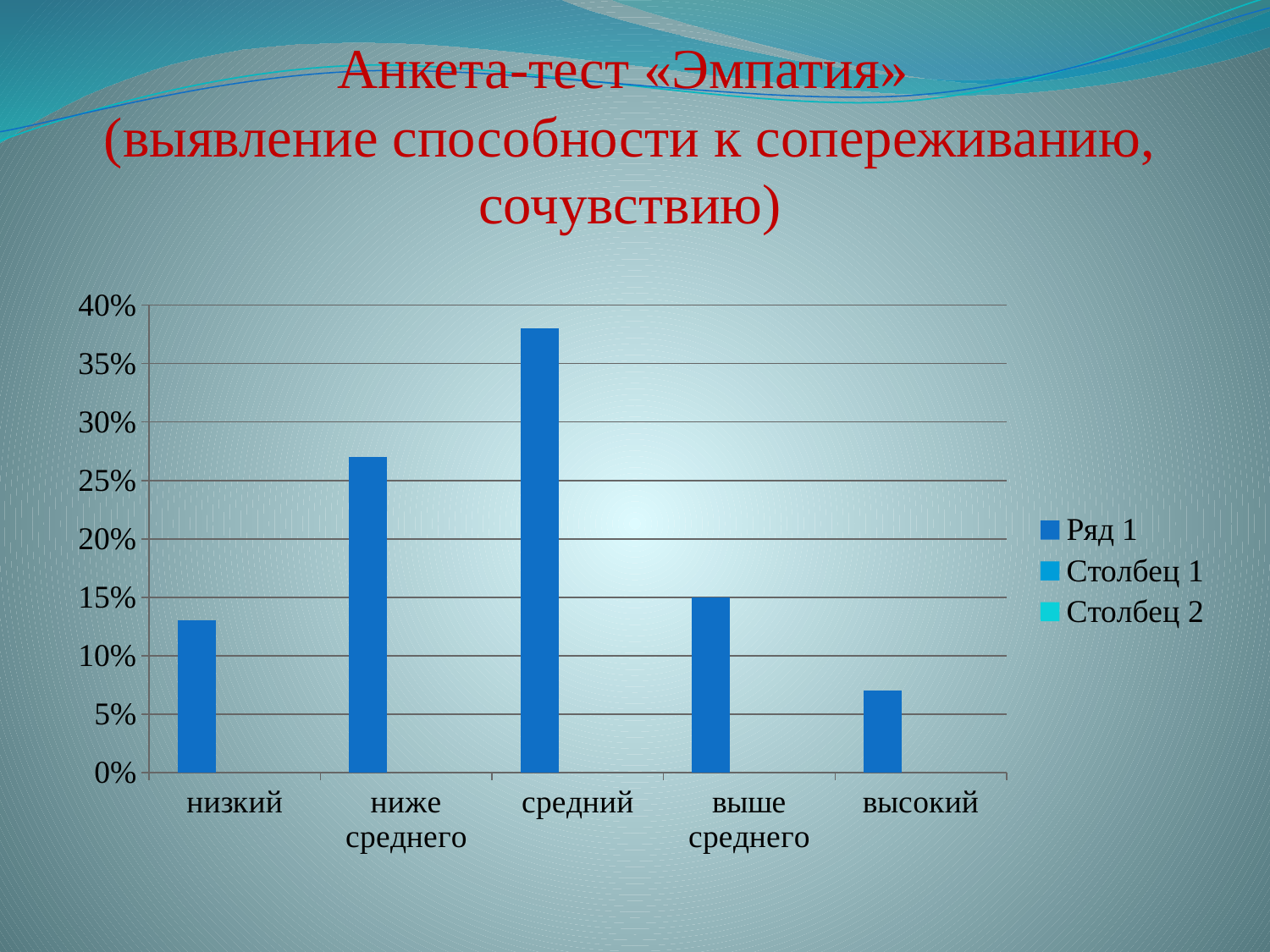
Is the value for "ниже среднего" greater or less than 25%? greater What kind of chart is shown on the slide? bar chart Is the value for "низкий" greater or less than 10%? greater Is the value for "средний" greater or less than 35%? greater Which category has the highest bar? средний What is the value for "выше среднего"? 15% How many categories are shown on the x axis of the chart? 5 Which is larger, the value for "ниже среднего" or the value for "выше среднего"? ниже среднего How many series does the legend list? 3 Which category has the lowest bar? высокий What is the name of the first series listed in the legend? Ряд 1